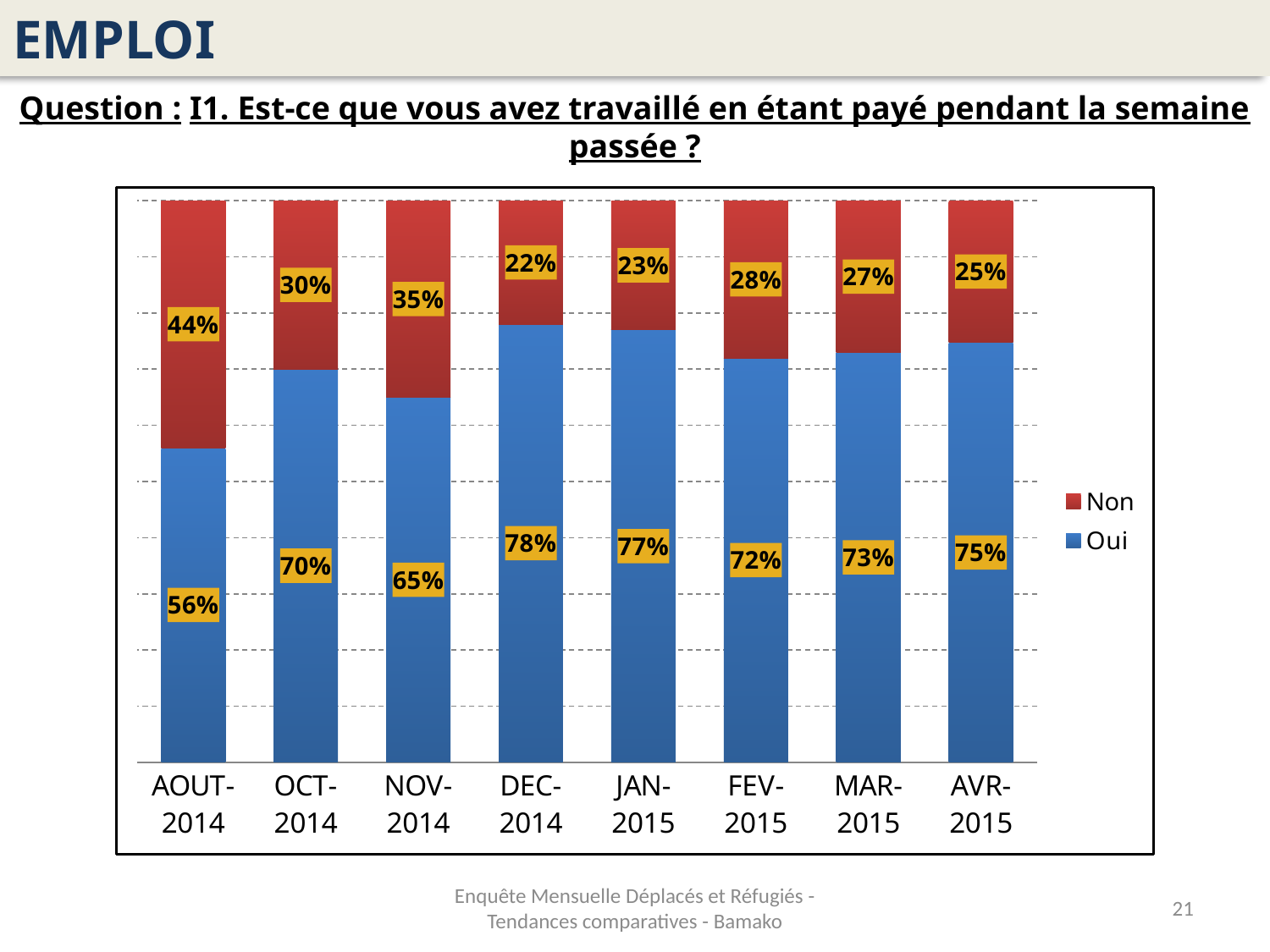
What is the value for Non in AOUT-2014? 44% Which is larger, the Non value for NOV-2014 or the Non value for OCT-2014? NOV-2014 How many months are shown on the x axis? 8 How many series does the legend list? 2 Which month has the lowest value for Oui? AOUT-2014 What is the value for Oui in DEC-2014? 78% Which month has the highest value for Non? AOUT-2014 What is the total of the stacked bar for MAR-2015? 100% What is the difference between the Oui values for DEC-2014 and AOUT-2014? 22% What is the value for Oui in FEV-2015? 72% What kind of chart is shown on the slide? Stacked bar chart Which month has the highest value for Oui? DEC-2014